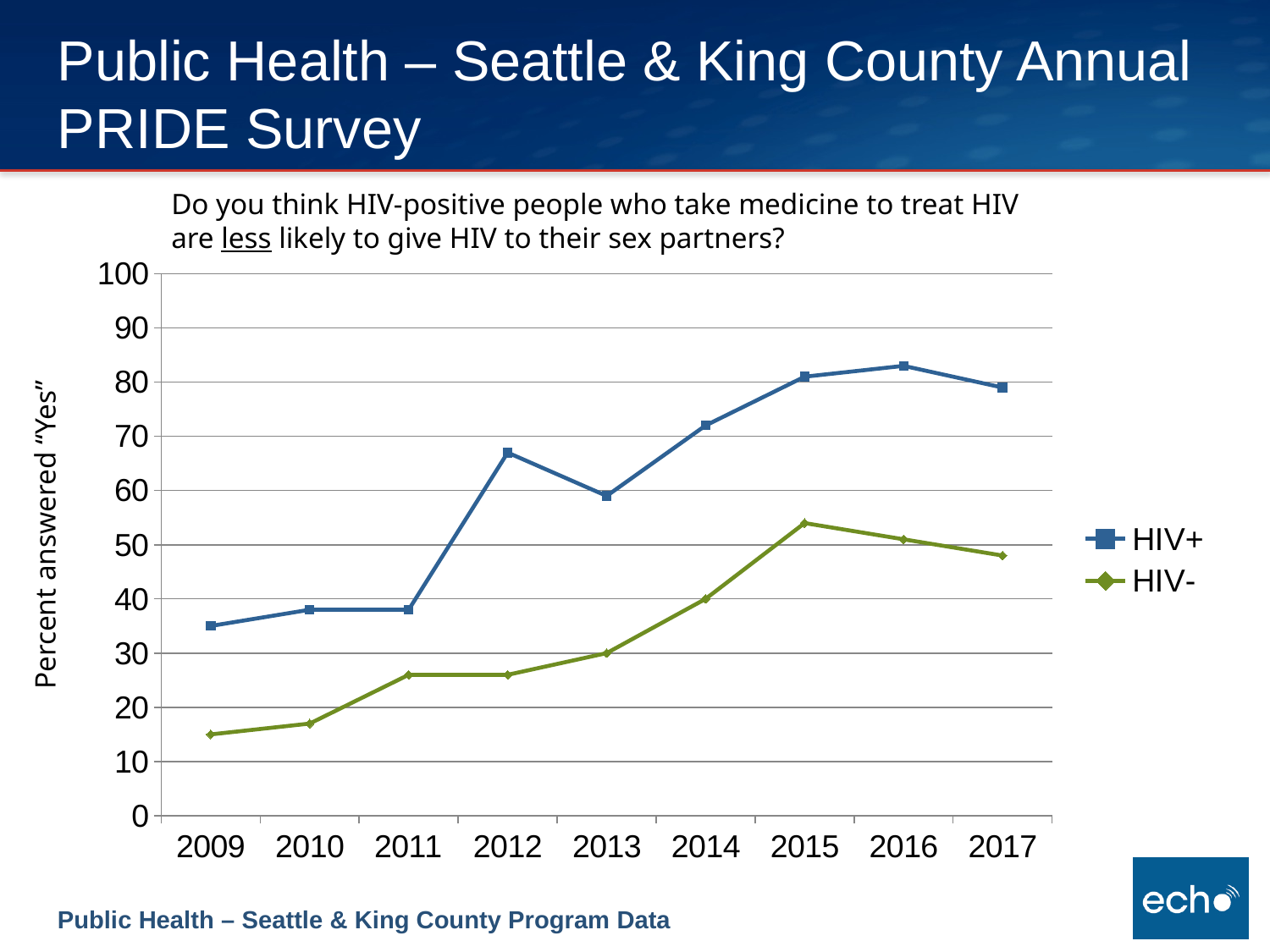
What is the value for HIV- in 2014? 40 In which year is the HIV- series at its lowest value? 2009 How many series does the legend list? 2 Does the HIV- series rise or fall from 2009 to 2015? rise Is the value for HIV+ in 2013 greater or less than 50? greater In 2012, which series has the larger value, HIV+ or HIV-? HIV+ Is the value for HIV- in 2015 greater or less than 50? greater What kind of chart is shown on the slide? line chart Is the value for HIV+ in 2009 greater or less than 40? less What is the label on the y axis? Percent answered "Yes" How many years are plotted along the x axis? 9 In which year does the HIV+ series reach its highest value? 2016